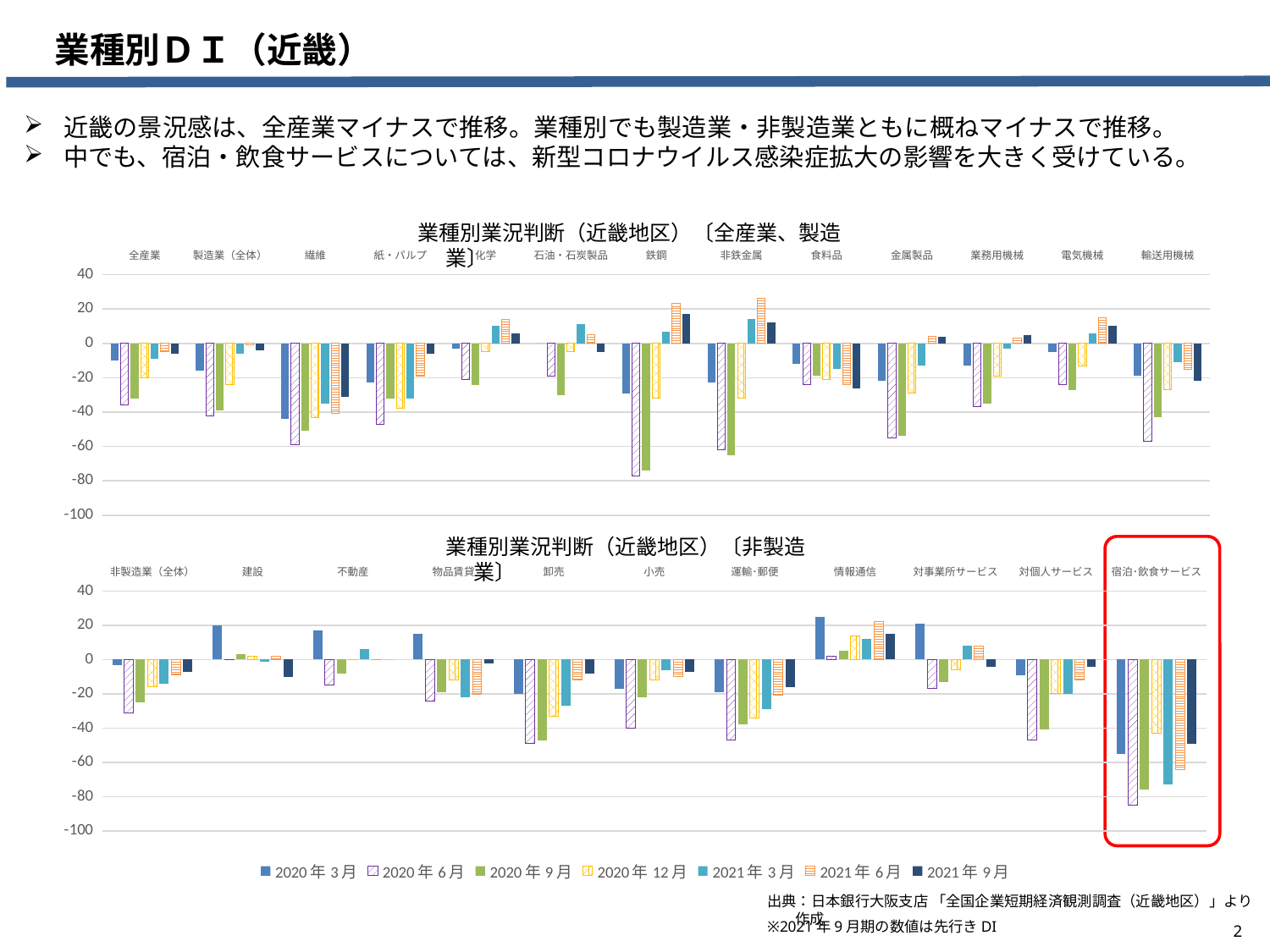
How many industry categories are shown on the x axis of the top chart 〔全産業、製造業〕? 13 In the bottom chart 〔非製造業〕, which category has the lowest 2020年6月 value? 宿泊・飲食サービス In the bottom chart 〔非製造業〕, is the 2020年3月 value for 建設 greater or less than 0? greater How many industry categories are shown on the x axis of the bottom chart 〔非製造業〕? 11 In the top chart 〔全産業、製造業〕, which has the lower 2020年6月 value, 繊維 or 鉄鋼? 鉄鋼 What kind of chart is the top chart titled 業種別業況判断（近畿地区）〔全産業、製造業〕? bar chart In the bottom chart 〔非製造業〕, is the 2020年6月 value for 宿泊・飲食サービス greater or less than -60? less In the bottom chart 〔非製造業〕, which category has the highest 2020年3月 value? 情報通信 In the bottom chart 〔非製造業〕, which category is highlighted with a red box? 宿泊・飲食サービス How many series does the legend list for the charts on this slide? 7 In the top chart 〔全産業、製造業〕, which category has the lowest 2020年6月 value? 鉄鋼 In the top chart 〔全産業、製造業〕, is the 2020年6月 value for 鉄鋼 greater or less than -60? less